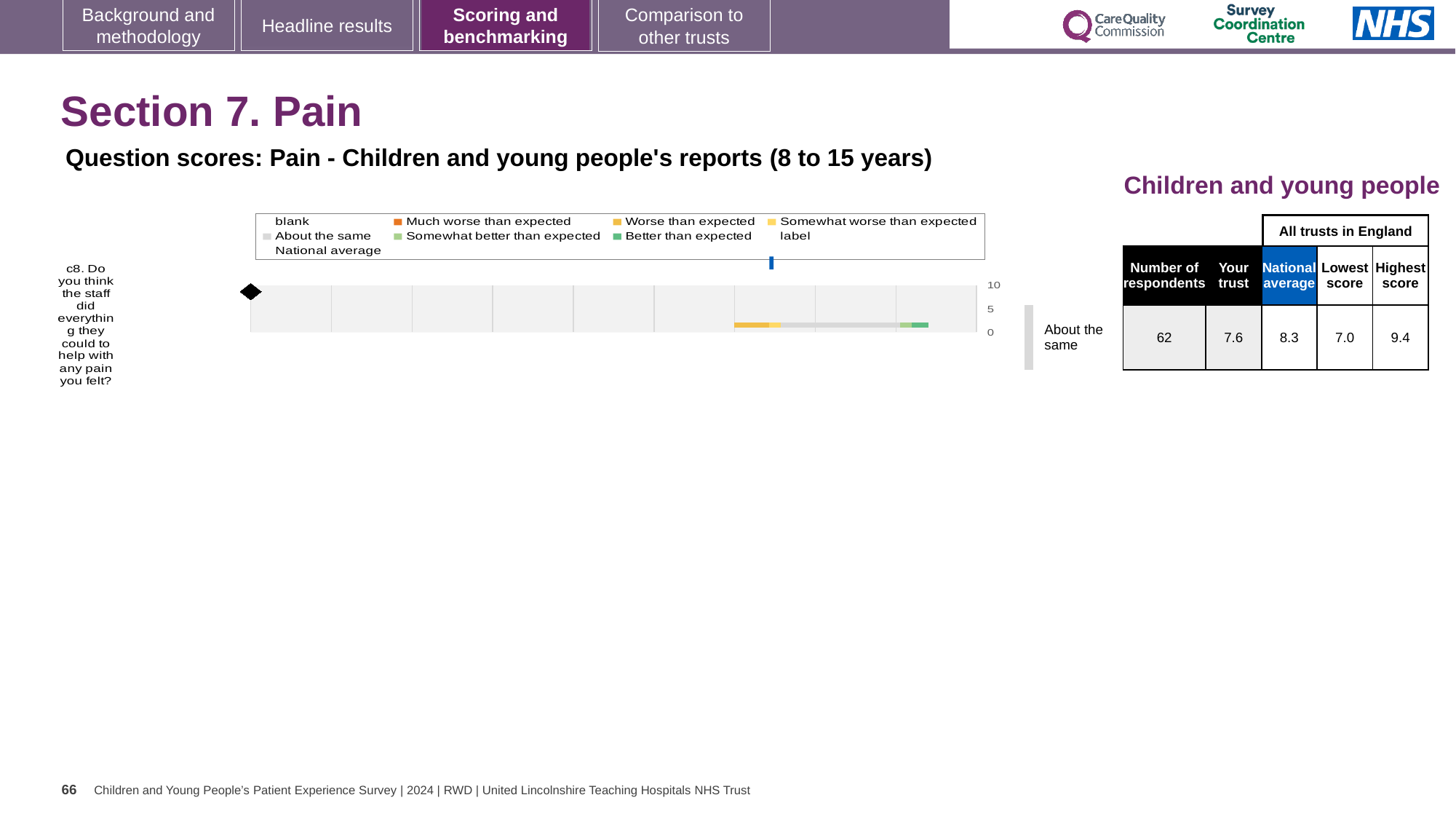
According to the table beside the chart, what is the 'Your trust' score for question c8? 7.6 How many entries does the chart legend list? 9 What is the question label shown on the chart's category axis? c8. Do you think the staff did everything they could to help with any pain you felt? Which is larger for question c8: the 'Your trust' score or the National average? National average According to the table beside the chart, what is the Highest score among all trusts in England for question c8? 9.4 According to the table beside the chart, what is the Lowest score among all trusts in England for question c8? 7.0 What is the difference between the Highest score and the Lowest score for question c8 in the table beside the chart? 2.4 According to the table beside the chart, what is the National average score for question c8? 8.3 How many questions (categories) are plotted in the chart? 1 What kind of chart is shown on the slide? bar chart According to the table beside the chart, how many respondents answered question c8? 62 What is the highest value shown on the chart's numeric axis? 10